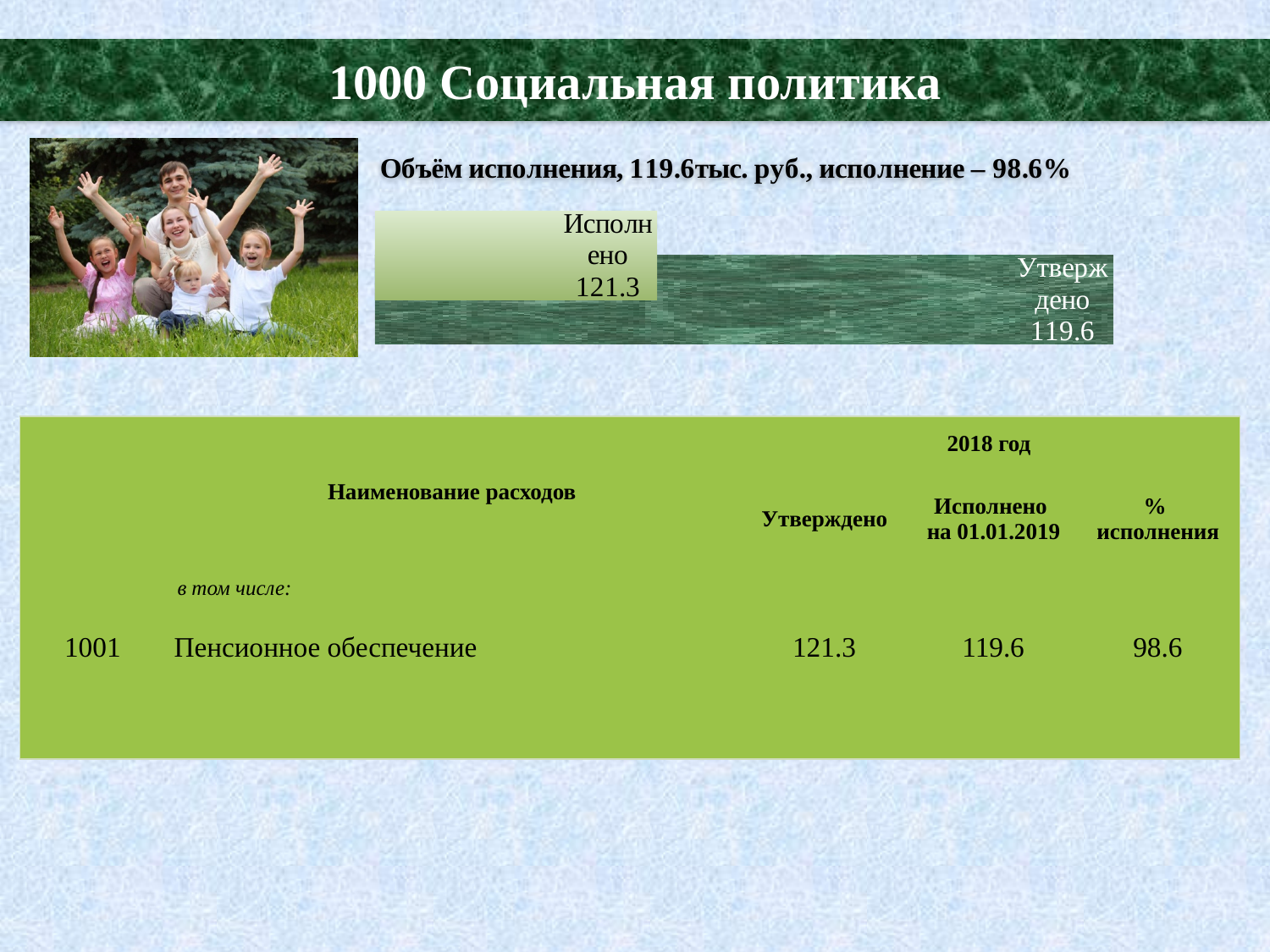
What kind of chart is shown on the slide? bar chart Is the value printed for "Исполнено" in the chart greater or less than 120? greater How many bars does the chart show? 2 What is the difference between the values printed for "Исполнено" and "Утверждено" in the chart? 1.7 What value is printed on the bar labelled "Исполнено" in the chart? 121.3 Which printed value in the chart is the smallest? Утверждено (119.6) What colour is the bar labelled "Утверждено" in the chart? dark green What value is printed on the bar labelled "Утверждено" in the chart? 119.6 Which printed value in the chart is larger, "Исполнено" or "Утверждено"? Исполнено Is the value printed for "Утверждено" in the chart greater or less than 120? less What colour is the bar labelled "Исполнено" in the chart? light green